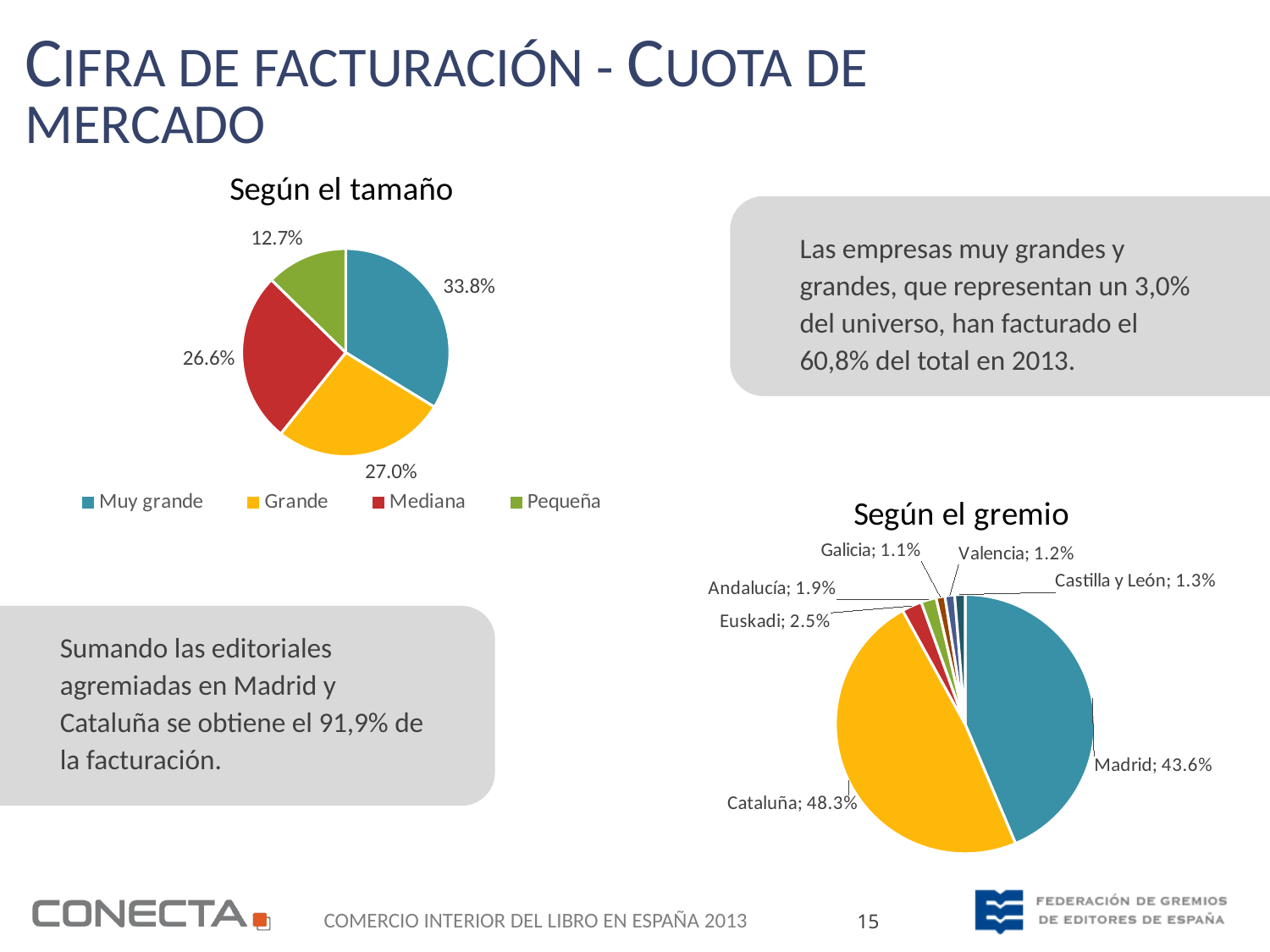
In the 'Según el gremio' chart, which region has the smallest share? Galicia In the 'Según el gremio' chart, what share is shown for Euskadi? 2.5% In the 'Según el gremio' chart, what share is shown for Cataluña? 48.3% In the 'Según el gremio' chart, how many regions are shown? 7 In the 'Según el tamaño' chart, how many categories does the legend list? 4 In the 'Según el tamaño' chart, what share is shown for Muy grande? 33.8% In the 'Según el tamaño' chart, what share is shown for Pequeña? 12.7% In the 'Según el tamaño' chart, which category has the largest slice? Muy grande What kind of chart is 'Según el gremio'? Pie chart In the 'Según el tamaño' chart, what is the difference between the Muy grande and Grande shares? 6.8% In the 'Según el tamaño' chart, which category has the smallest slice? Pequeña In the 'Según el gremio' chart, what is the difference between the Cataluña and Madrid shares? 4.7%